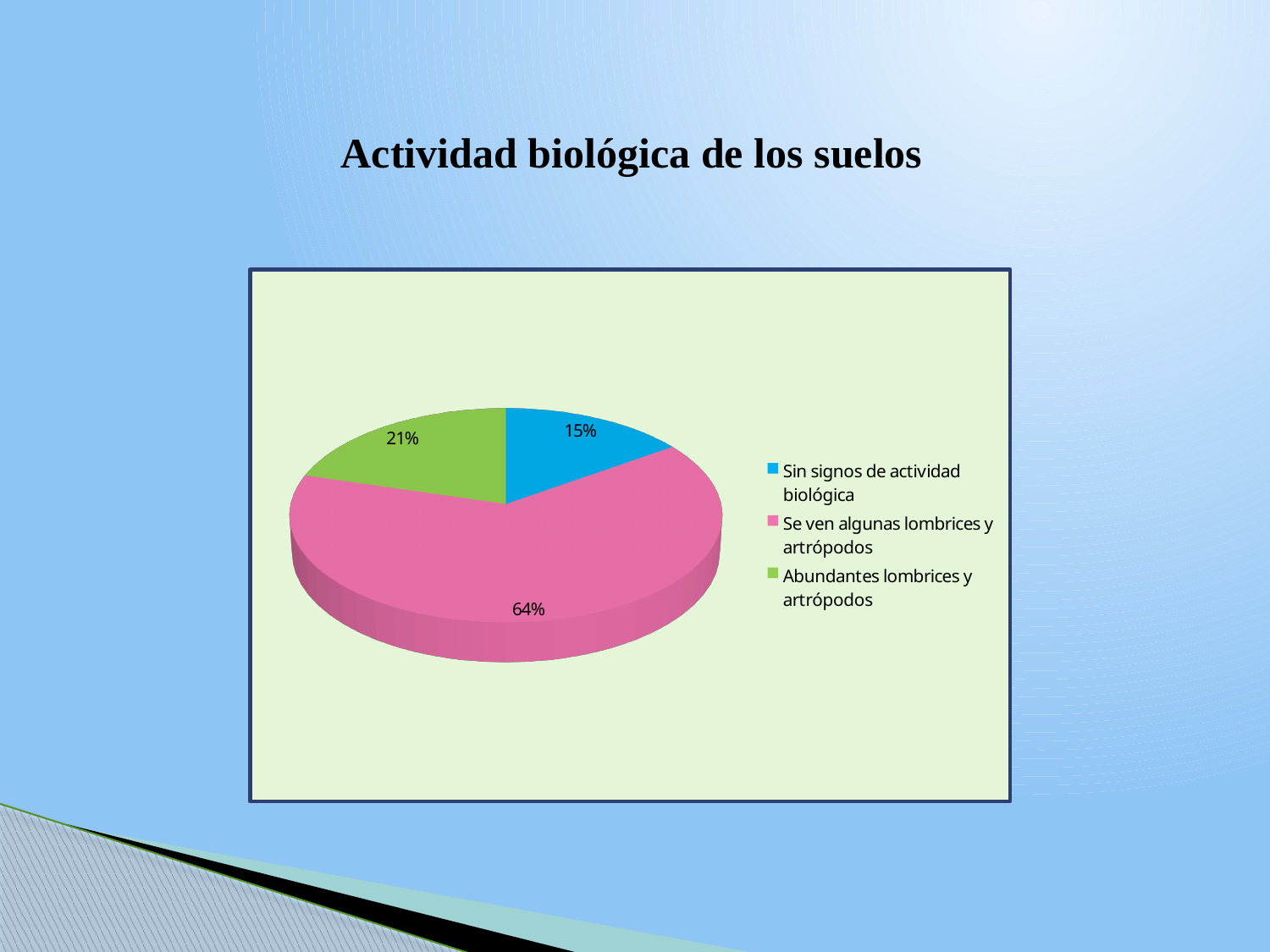
What is the difference in percentage points between 'Se ven algunas lombrices y artrópodos' and 'Abundantes lombrices y artrópodos'? 43 percentage points What share of the pie is 'Sin signos de actividad biológica'? 15% What colour is the slice for 'Se ven algunas lombrices y artrópodos'? pink What share of the pie is 'Se ven algunas lombrices y artrópodos'? 64% What kind of chart is shown on the slide? pie chart What is the difference in percentage points between 'Abundantes lombrices y artrópodos' and 'Sin signos de actividad biológica'? 6 percentage points Which is larger: the share for 'Abundantes lombrices y artrópodos' or the share for 'Sin signos de actividad biológica'? Abundantes lombrices y artrópodos Which category has the largest share of the pie? Se ven algunas lombrices y artrópodos What is the title of the slide above the chart? Actividad biológica de los suelos Which category has the smallest share of the pie? Sin signos de actividad biológica What share of the pie is 'Abundantes lombrices y artrópodos'? 21% How many slices does the pie chart have? 3